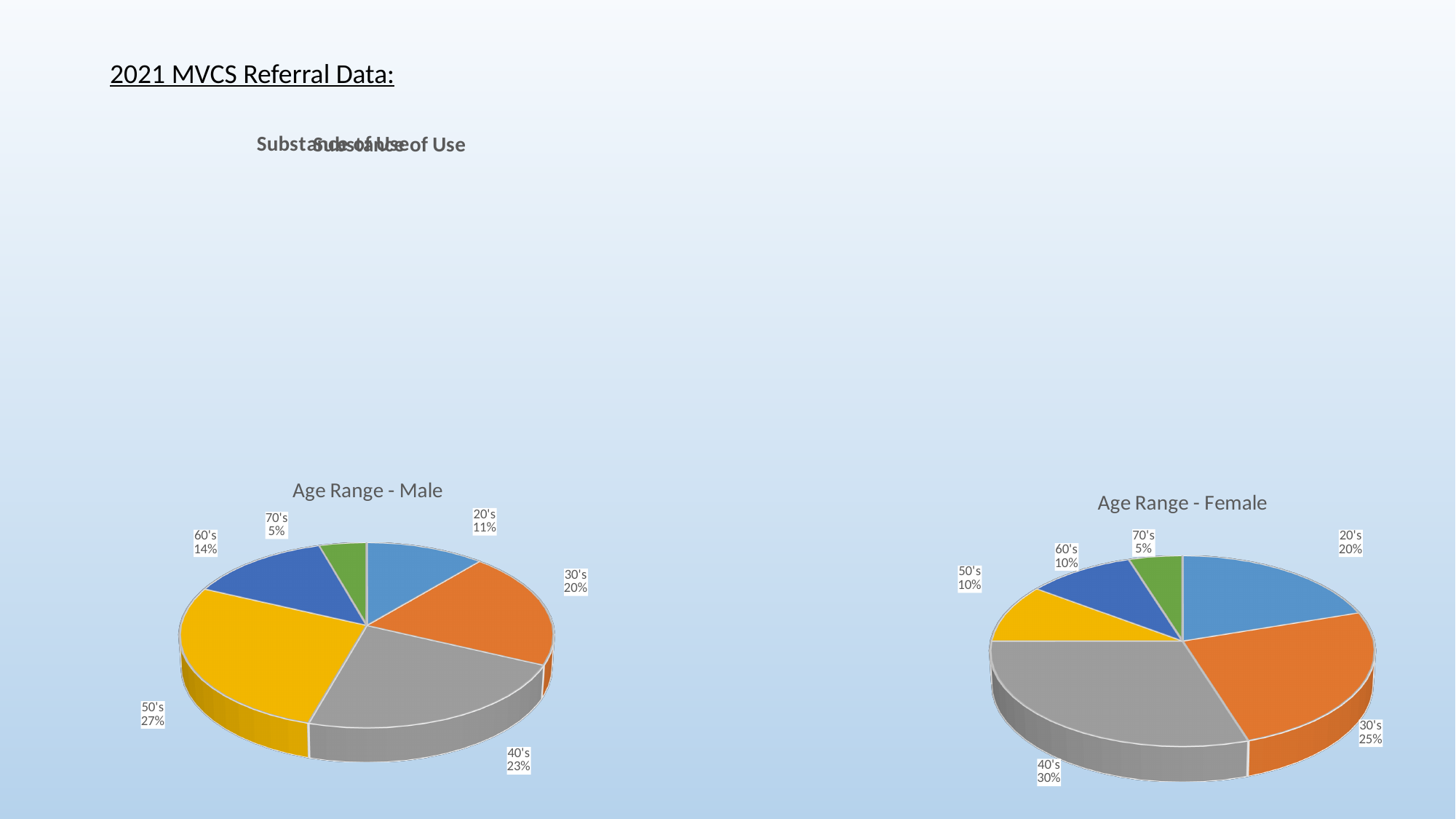
How many age range categories are shown in the Age Range - Male chart? 6 In the Age Range - Female chart, what is the difference in percentage points between the 40's slice and the 60's slice? 20 In the Age Range - Male chart, what is the difference in percentage points between the 40's slice and the 20's slice? 12 In the Age Range - Female chart, what percentage is labelled for the 20's slice? 20% In the Age Range - Male chart, what percentage is labelled for the 60's slice? 14% What kind of chart is the Age Range - Female chart? Pie chart In the Age Range - Female chart, which is larger, the 30's slice or the 50's slice? 30's In the Age Range - Male chart, which age range has the largest slice? 50's In the Age Range - Female chart, which age range has the smallest slice? 70's In the Age Range - Female chart, what share of the pie is the 40's slice? 30% In the Age Range - Male chart, what share of the pie is the 50's slice? 27% What is the title of the pie chart on the right side of the slide? Age Range - Female